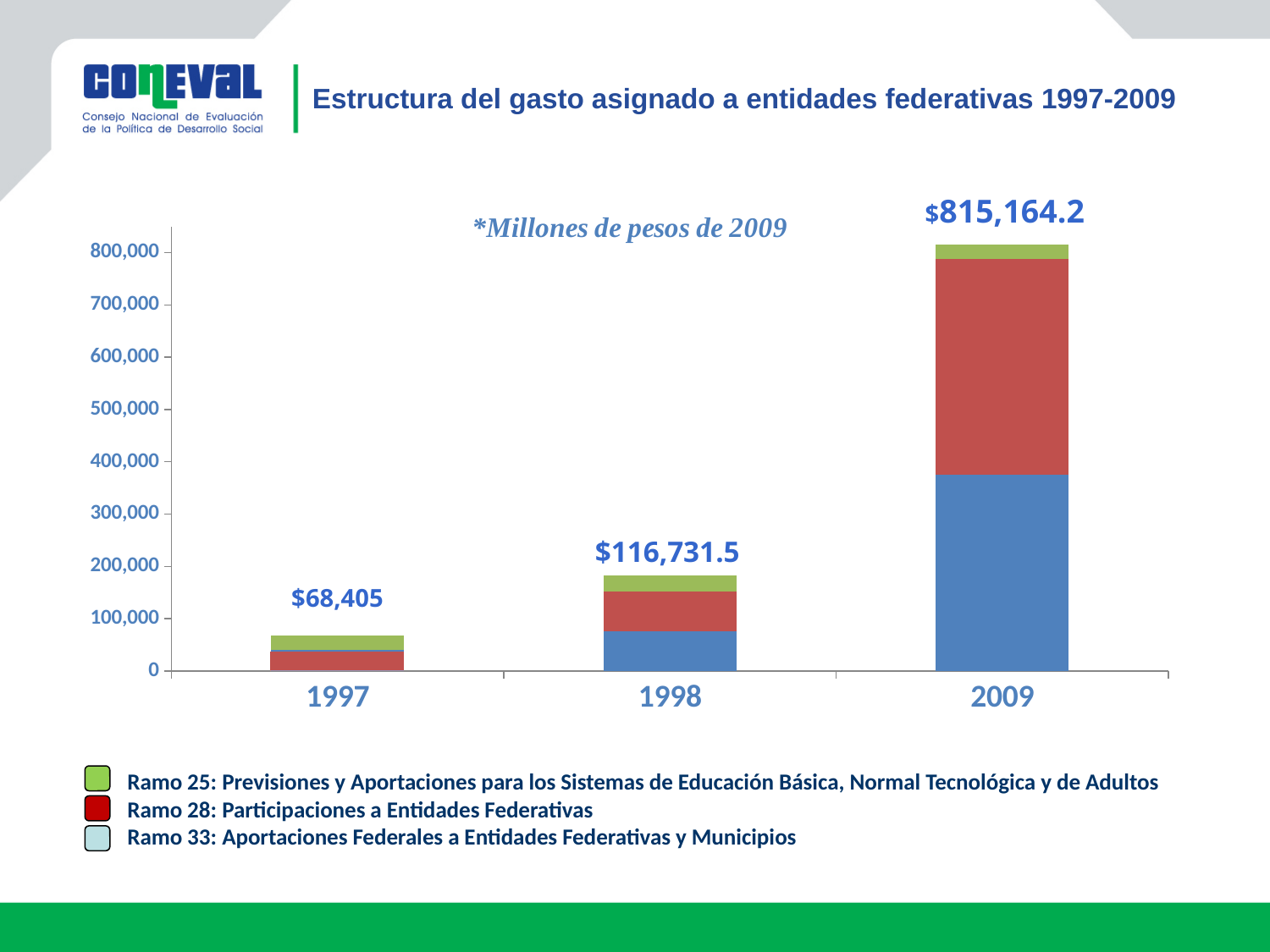
What is the difference between the totals for 2009 and 1998? 698,432.7 What is the total value shown for 1998? $116,731.5 Which year has the lowest total? 1997 Is the value of the blue (Ramo 33) segment for 2009 greater or less than 300,000? greater What is the total value shown for 1997? $68,405 What is the difference between the totals for 1998 and 1997? 48,326.5 What is the total value shown for 2009? $815,164.2 How many series does the legend list? 3 How many years are shown on the x axis? 3 Do the totals rise or fall from 1997 to 2009? rise Which is larger, the total for 1998 or the total for 1997? 1998 Which year has the highest total? 2009